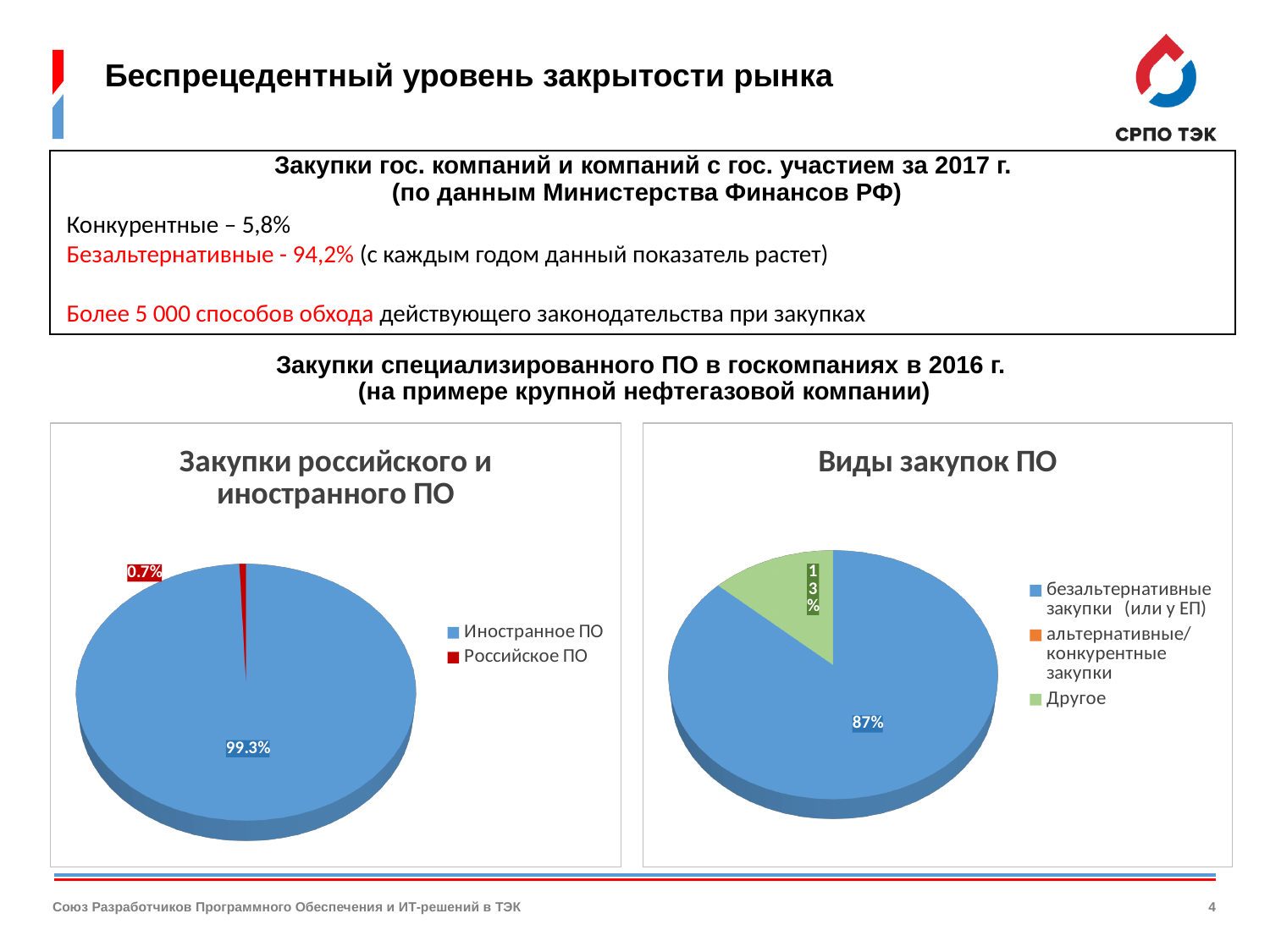
In the chart titled "Закупки российского и иностранного ПО", what share is labelled for Российское ПО? 0.7% In the chart titled "Закупки российского и иностранного ПО", what is the difference in percentage points between Иностранное ПО and Российское ПО? 98.6 In the chart titled "Закупки российского и иностранного ПО", what share is labelled for Иностранное ПО? 99.3% In the chart titled "Закупки российского и иностранного ПО", what colour is the slice for Иностранное ПО? Blue In the chart titled "Виды закупок ПО", what share is labelled for Другое? 13% In the chart titled "Закупки российского и иностранного ПО", which category has the smallest slice? Российское ПО In the chart titled "Закупки российского и иностранного ПО", which category has the largest slice? Иностранное ПО In the chart titled "Виды закупок ПО", which category has the largest slice? безальтернативные закупки (или у ЕП) In the chart titled "Виды закупок ПО", which is larger: безальтернативные закупки (или у ЕП) or Другое? безальтернативные закупки (или у ЕП) In the chart titled "Виды закупок ПО", how many entries does the legend list? 3 What kind of chart is the chart titled "Закупки российского и иностранного ПО"? Pie chart In the chart titled "Виды закупок ПО", what share is labelled for безальтернативные закупки (или у ЕП)? 87%